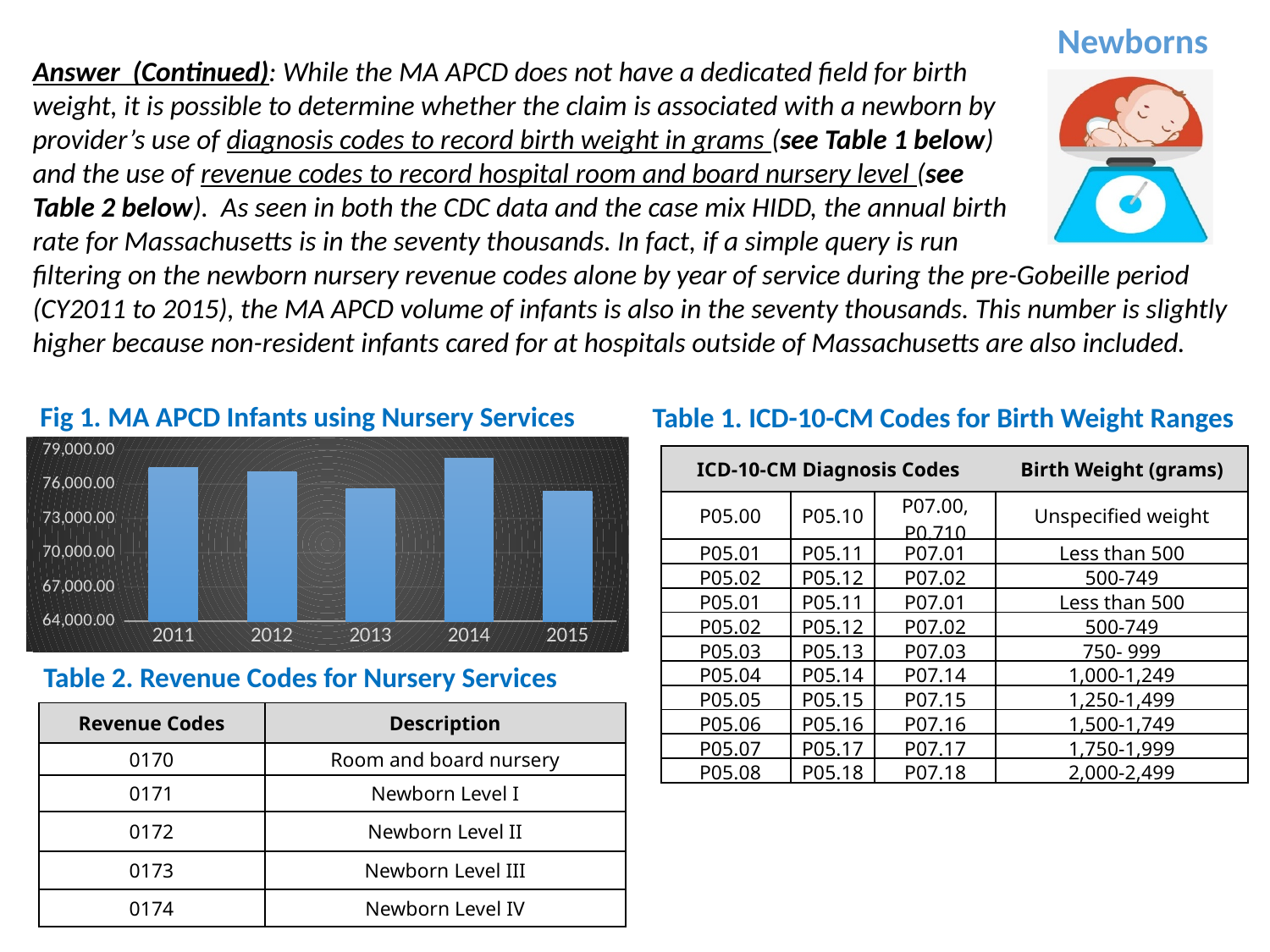
In Fig 1. MA APCD Infants using Nursery Services, which year has the highest value? 2014 In Fig 1. MA APCD Infants using Nursery Services, does the value rise or fall from 2013 to 2014? rise What kind of chart is Fig 1. MA APCD Infants using Nursery Services? bar chart In Fig 1. MA APCD Infants using Nursery Services, is the value for 2013 greater or less than 73,000.00? greater In Fig 1. MA APCD Infants using Nursery Services, which is larger, the value for 2011 or the value for 2013? 2011 In Fig 1. MA APCD Infants using Nursery Services, which is larger, the value for 2014 or the value for 2013? 2014 What is the lowest tick value shown on the y axis of Fig 1. MA APCD Infants using Nursery Services? 64,000.00 In Fig 1. MA APCD Infants using Nursery Services, is the value for 2011 greater or less than 76,000.00? greater In Fig 1. MA APCD Infants using Nursery Services, is the value for 2014 greater or less than 76,000.00? greater In Fig 1. MA APCD Infants using Nursery Services, does the value rise or fall from 2014 to 2015? fall How many years are shown on the x axis of Fig 1. MA APCD Infants using Nursery Services? 5